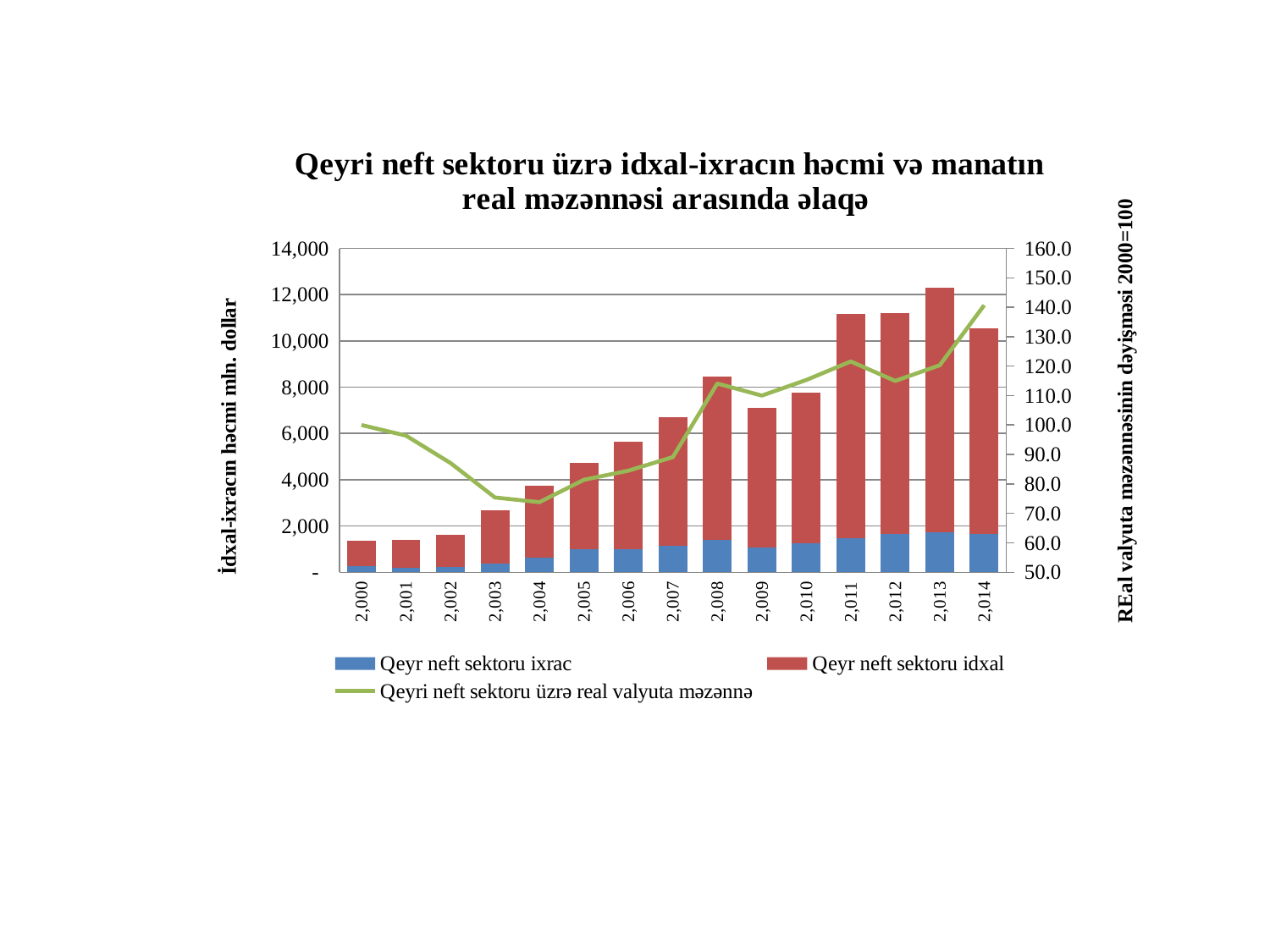
What is the value of the real exchange rate line in 2,000? 100.0 What colour represents the series 'Qeyr neft sektoru idxal' in the chart? Red In which year is the total stacked bar (import plus export) the tallest? 2,013 In which year does the real exchange rate line reach its lowest point? 2,004 Is the real exchange rate line value for 2,004 greater or less than 80.0? less Is the total stacked bar for 2,011 greater or less than 10,000? greater How many series does the chart's legend list? 3 How many years are shown on the x axis of the chart? 15 Which year has a larger total stacked bar, 2,010 or 2,011? 2,011 What kind of chart is shown on the slide? A combined bar and line chart (stacked bars with a line) In which year does the real exchange rate line (Qeyri neft sektoru üzrə real valyuta məzənnə) reach its highest point? 2,014 Is the real exchange rate line value for 2,014 greater or less than 130.0? greater